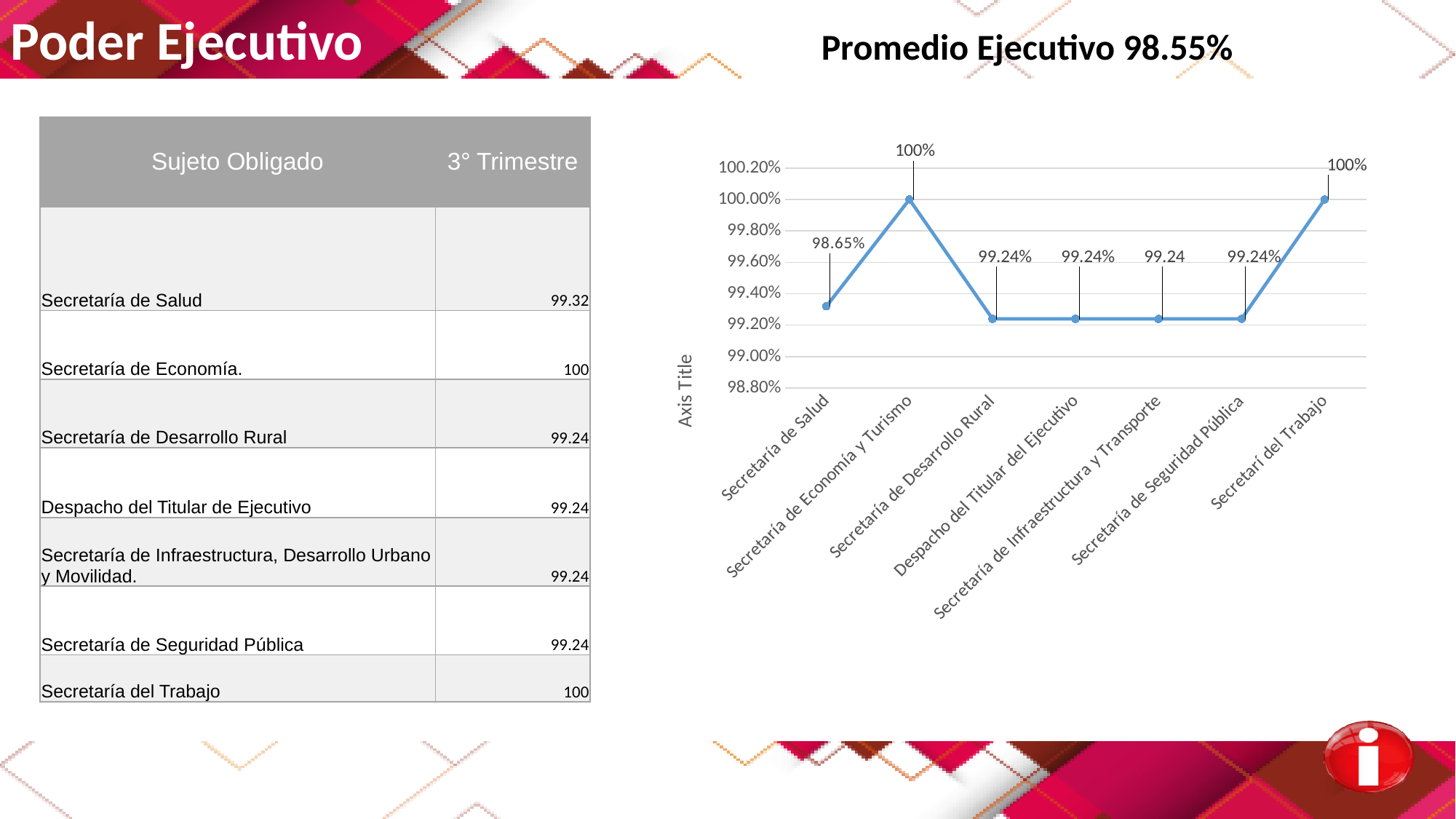
What is the difference between the value for Secretaría de Economía y Turismo and the value for Despacho del Titular del Ejecutivo in the chart? 0.76% What is the label shown on the vertical axis of the chart? Axis Title What kind of chart is shown on the slide? line chart What is the value for Secretarí del Trabajo in the chart? 100% What is the value for Secretaría de Economía y Turismo in the chart? 100% What is the value for Secretaría de Desarrollo Rural in the chart? 99.24% Is the value for Despacho del Titular del Ejecutivo greater or less than 99.40%? less Between Secretaría de Seguridad Pública and Secretarí del Trabajo, does the line rise or fall? rise How many categories are plotted along the x axis of the chart? 7 Which is larger in the chart: the value for Secretaría de Economía y Turismo or the value for Secretaría de Desarrollo Rural? Secretaría de Economía y Turismo What data label is shown for Secretaría de Infraestructura y Transporte in the chart? 99.24 What is the value for Secretaría de Seguridad Pública in the chart? 99.24%